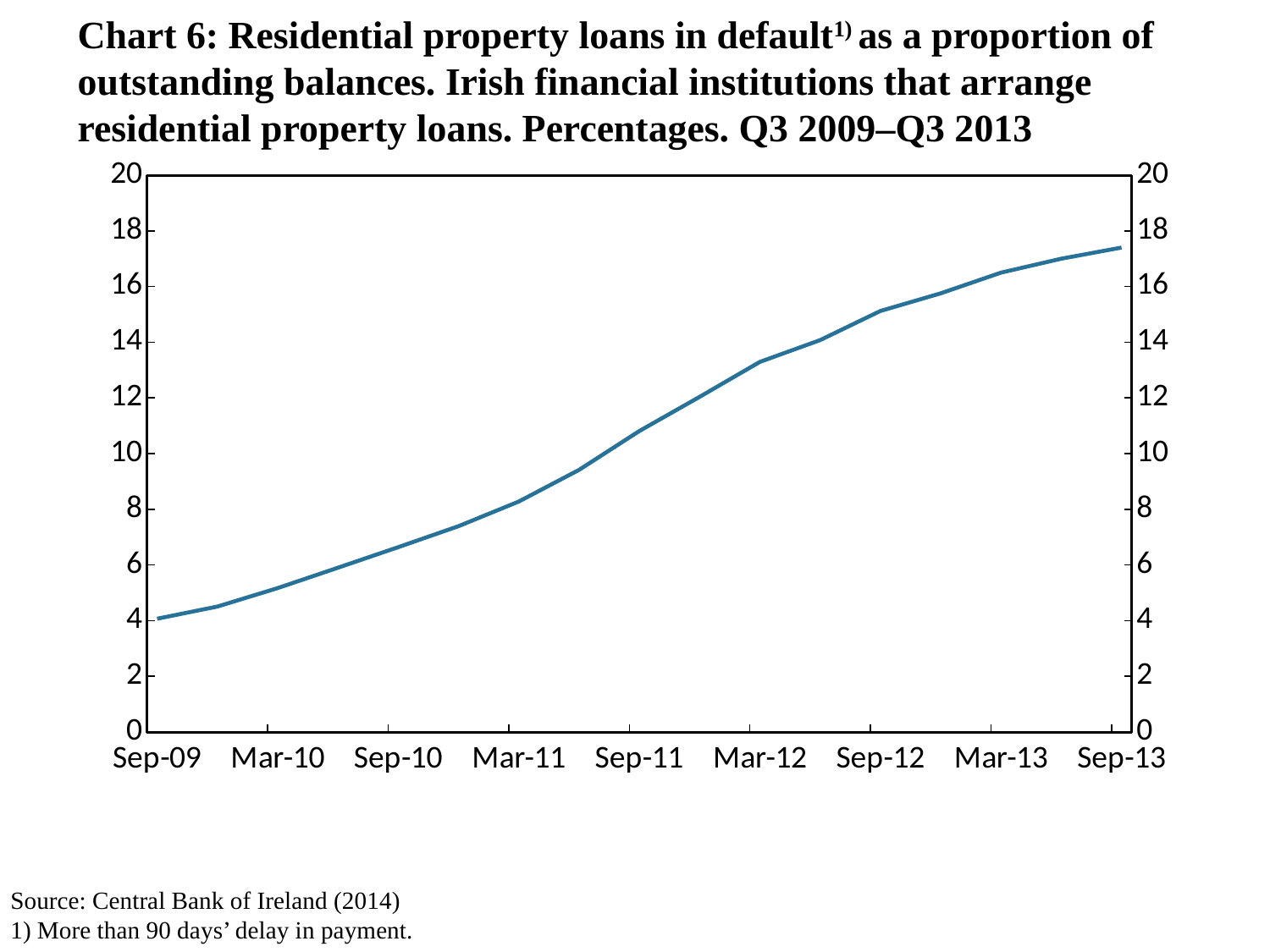
How many date labels are shown on the x axis? 9 Is the value for Sep-10 greater or less than 8? less At which date on the x axis is the proportion of loans in default highest? Sep-13 Do the values rise or fall from Sep-09 to Sep-13? rise At which date on the x axis is the proportion of loans in default lowest? Sep-09 What is the source given for the chart? Central Bank of Ireland (2014) Is the value for Sep-12 greater or less than 14? greater Is the value for Sep-13 greater or less than 16? greater What kind of chart is shown on the slide? line chart Which is larger, the value for Mar-11 or the value for Sep-11? Sep-11